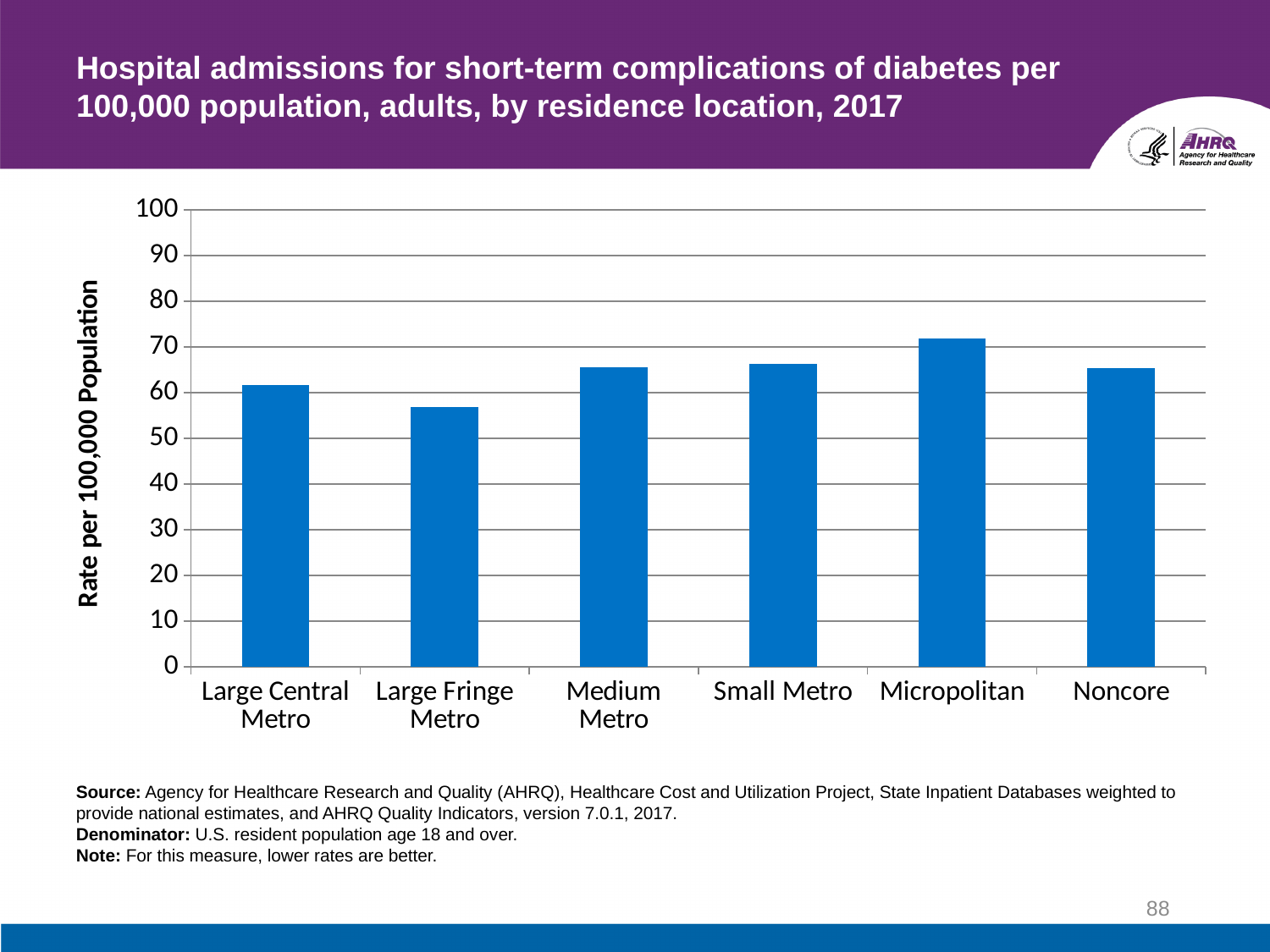
Is the value for Large Fringe Metro greater or less than 60? less Which residence location has the lowest rate of hospital admissions for short-term complications of diabetes? Large Fringe Metro Is the value for Noncore greater or less than 60? greater Which residence location has the highest rate of hospital admissions for short-term complications of diabetes? Micropolitan Which has a higher rate, Large Central Metro or Large Fringe Metro? Large Central Metro Is the value for Micropolitan greater or less than 70? greater What year of data does the chart title say is shown? 2017 Which has a higher rate, Micropolitan or Large Fringe Metro? Micropolitan How many residence location categories are shown on the x axis? 6 What kind of chart is shown on the slide? bar chart What is the label of the y axis? Rate per 100,000 Population